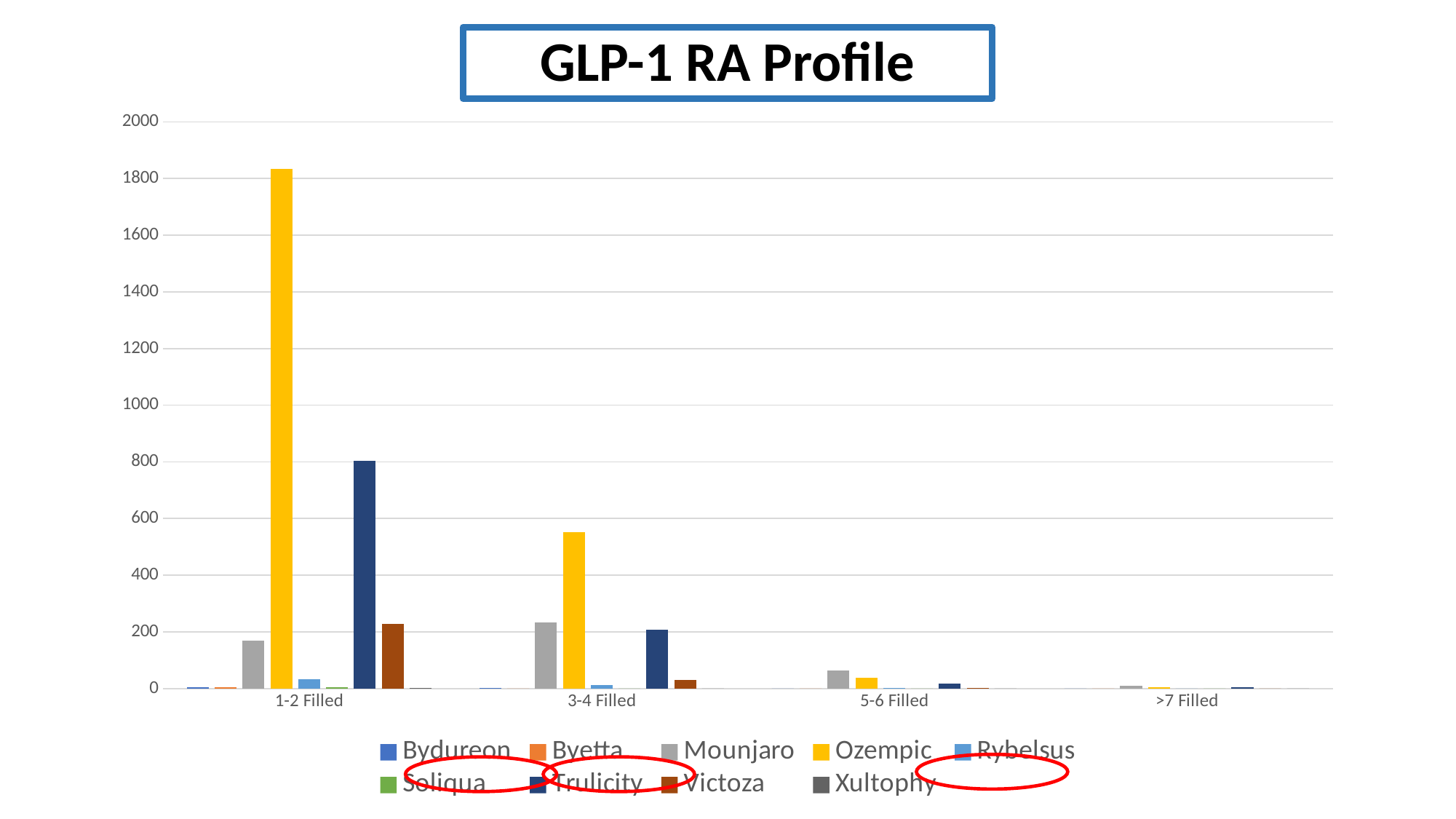
Is the value for Ozempic in the 3-4 Filled category greater or less than 400? greater Which is larger in the 1-2 Filled category, Trulicity or Victoza? Trulicity Is the value for Ozempic in the 1-2 Filled category greater or less than 1800? greater Is the value for Trulicity in the 1-2 Filled category greater or less than 1000? less Which series has the tallest bar in the 1-2 Filled category? Ozempic What is the title of the chart? GLP-1 RA Profile How many series does the legend list? 9 What kind of chart is shown on the slide? bar chart How many categories are shown on the x axis? 4 Which series has the tallest bar in the 3-4 Filled category? Ozempic Which is larger in the 3-4 Filled category, Mounjaro or Trulicity? Mounjaro Do the values for Ozempic rise or fall from 1-2 Filled to >7 Filled? fall